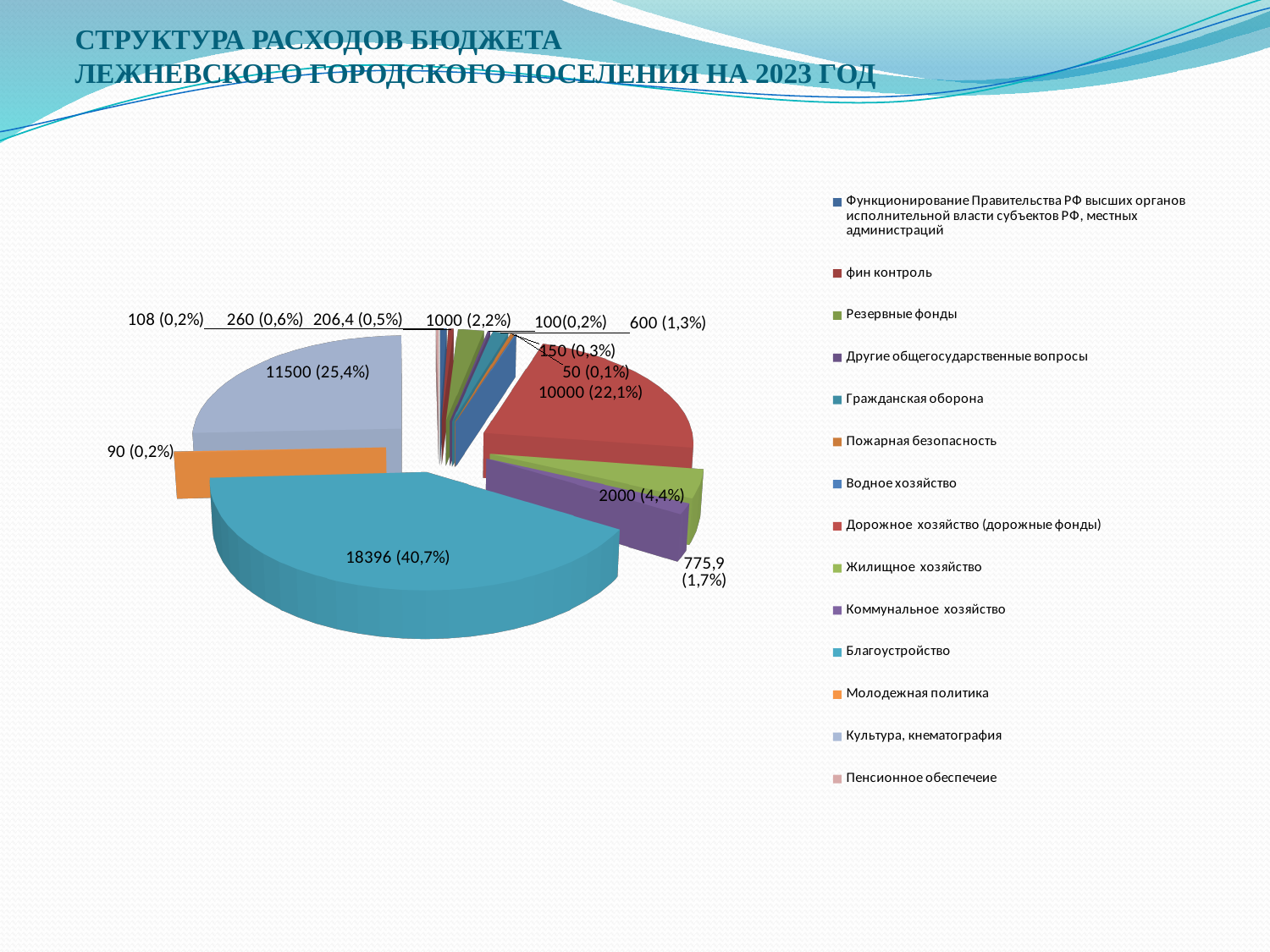
What value is shown for Благоустройство? 18396 (40,7%) What value is shown for Дорожное хозяйство (дорожные фонды)? 10000 (22,1%) How many categories does the legend of the pie chart list? 14 What value is shown for Культура, кнематография? 11500 (25,4%) What value is shown for Жилищное хозяйство? 2000 (4,4%) Which is larger, the value for Дорожное хозяйство (дорожные фонды) or the value for Жилищное хозяйство? Дорожное хозяйство (дорожные фонды) What is the difference between the value for Благоустройство and the value for Культура, кнематография? 6896 What is the title of the slide? СТРУКТУРА РАСХОДОВ БЮДЖЕТА ЛЕЖНЕВСКОГО ГОРОДСКОГО ПОСЕЛЕНИЯ НА 2023 ГОД What share of the pie does Культура, кнематография take? 25,4% What kind of chart is shown on the slide? pie chart What value is shown for Коммунальное хозяйство? 775,9 (1,7%) Which category has the largest slice of the pie? Благоустройство